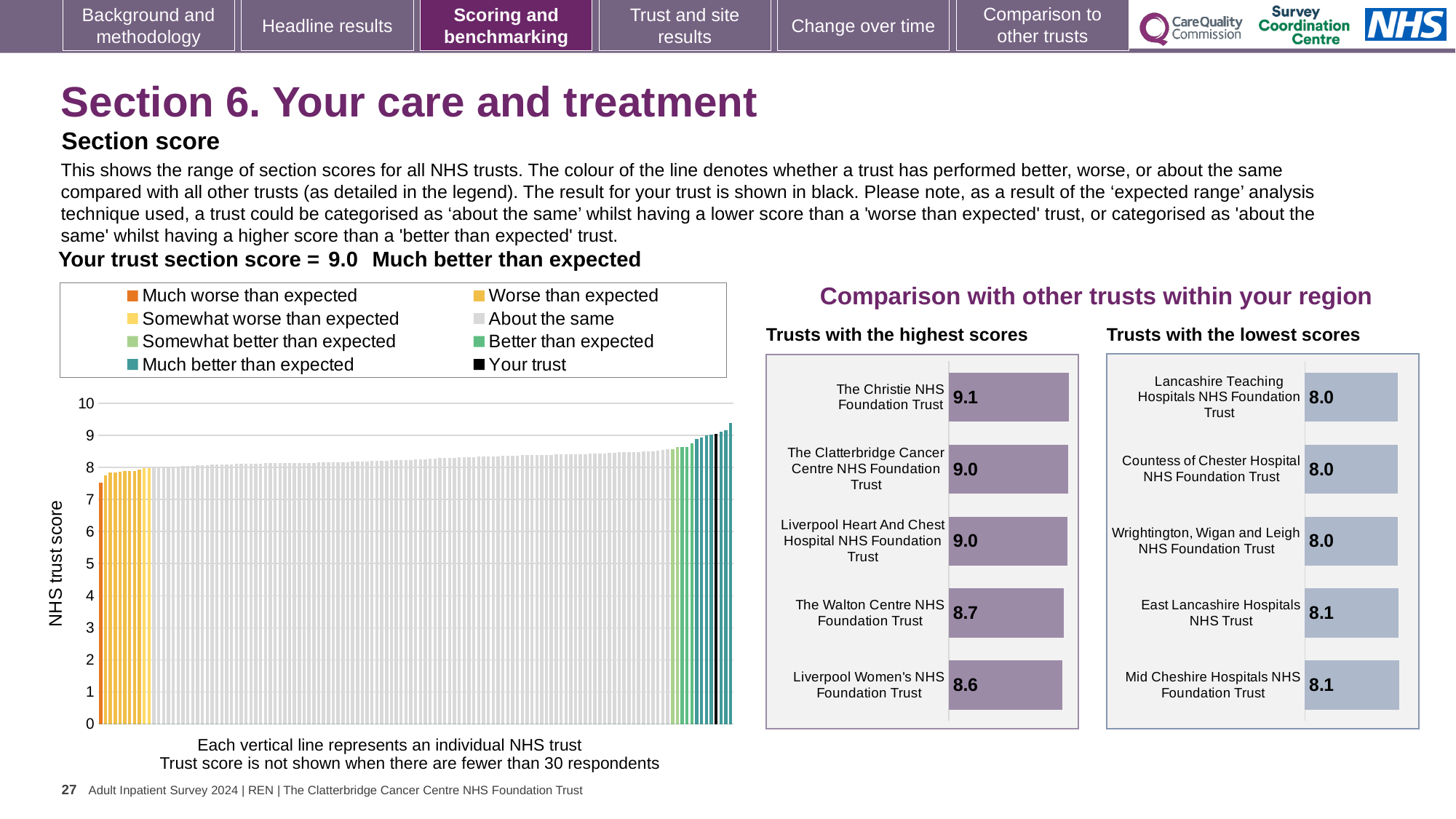
In the 'Trusts with the highest scores' chart, what is the score for The Christie NHS Foundation Trust? 9.1 In the 'Trusts with the highest scores' chart, what is the score for The Walton Centre NHS Foundation Trust? 8.7 In the 'Trusts with the lowest scores' chart, what is the score for East Lancashire Hospitals NHS Trust? 8.1 How many trusts are shown in the 'Trusts with the lowest scores' chart? 5 In the 'Trusts with the lowest scores' chart, which has the larger score: Mid Cheshire Hospitals NHS Foundation Trust or Countess of Chester Hospital NHS Foundation Trust? Mid Cheshire Hospitals NHS Foundation Trust In the 'Trusts with the highest scores' chart, which trust has the lowest score? Liverpool Women's NHS Foundation Trust In the 'Trusts with the highest scores' chart, what is the difference between the scores of The Christie NHS Foundation Trust and Liverpool Women's NHS Foundation Trust? 0.5 In the main NHS trust score chart on the left, do the trust scores rise or fall from left to right? rise In the 'Trusts with the highest scores' chart, which trust has the highest score? The Christie NHS Foundation Trust In the main NHS trust score chart on the left, what is the section score for your trust? 9.0 How many entries does the legend of the main NHS trust score chart list? 8 In the main NHS trust score chart on the left, is the value for your trust greater or less than 8? greater